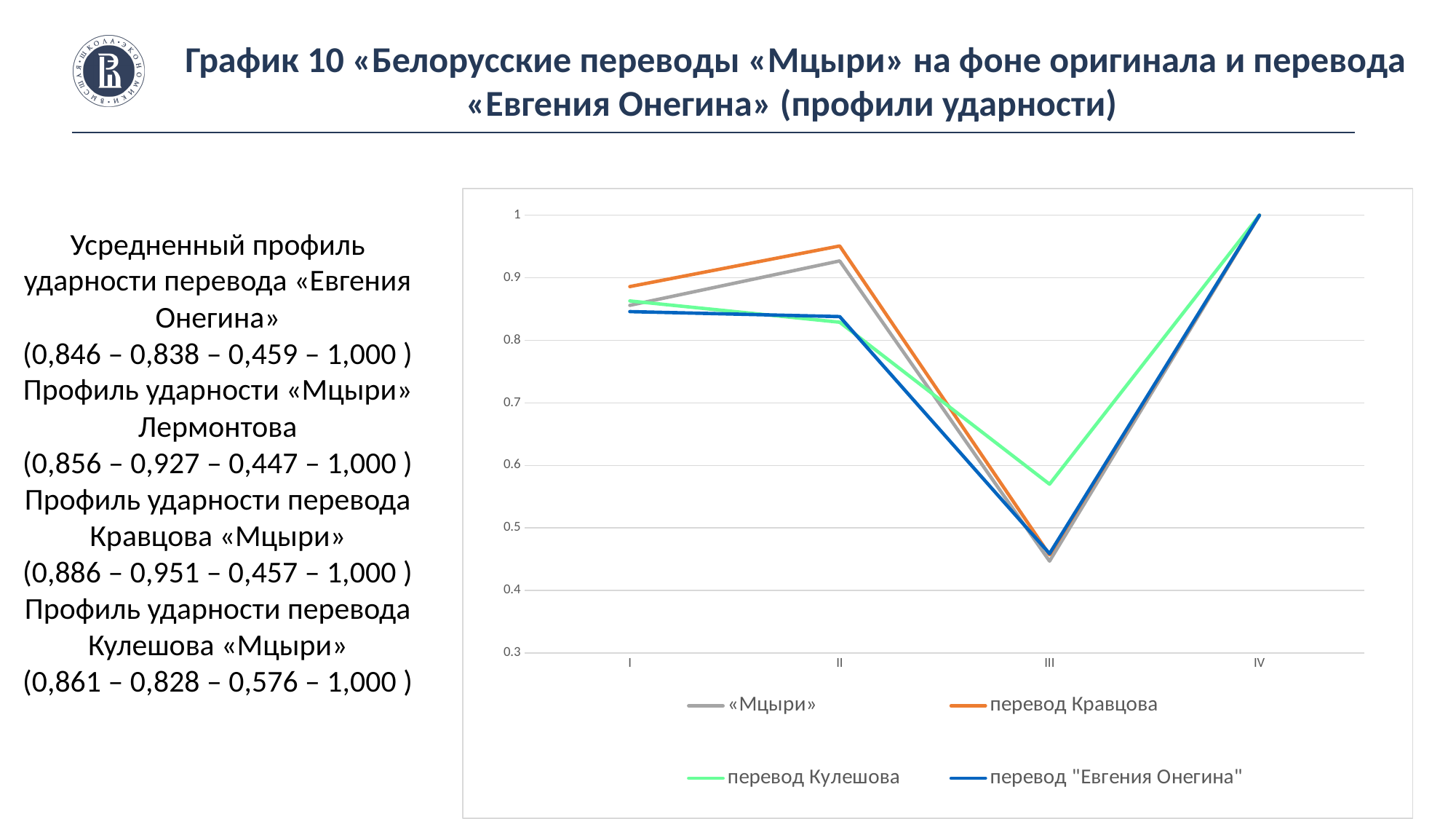
How many categories are on the x axis? 4 Is the value for «Мцыри» at III greater or less than 0.5? less Which series has the highest value at II? перевод Кравцова Is the value for «перевод Кулешова» at III greater or less than 0.5? greater How many series does the legend list? 4 Is the value for «перевод "Евгения Онегина"» at I greater or less than 0.9? less Do the values for «Мцыри» rise or fall from II to III? fall At II, which is larger: «перевод Кравцова» or «перевод Кулешова»? перевод Кравцова What is the value for «перевод Кравцова» at IV? 1 Which series has the highest value at III? перевод Кулешова What kind of chart is shown on the slide? line chart